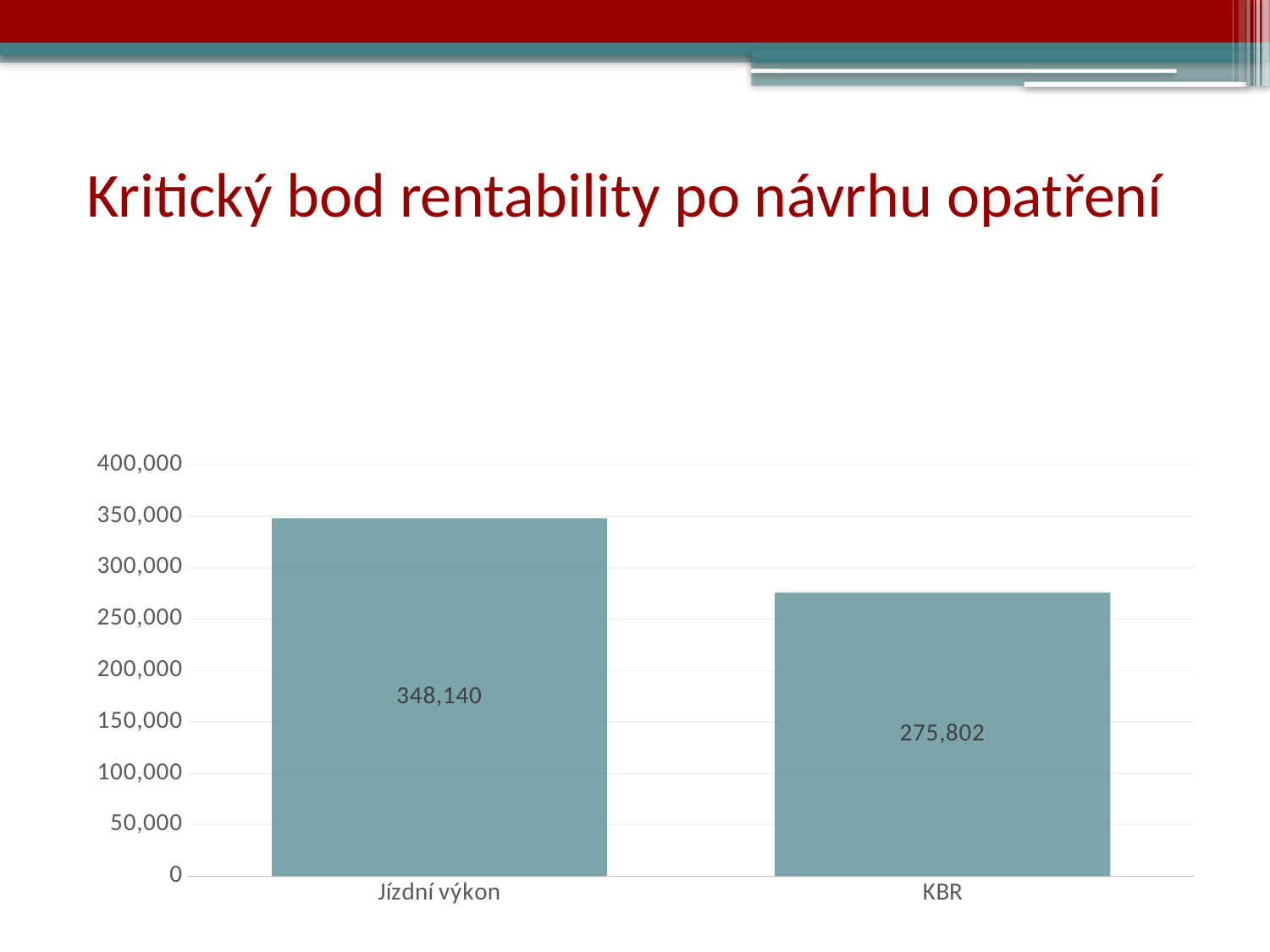
What is the value for Jízdní výkon? 348,140 How many categories are shown on the x axis? 2 What is the difference between the values for Jízdní výkon and KBR? 72,338 Is the value for KBR greater or less than 300,000? less Which category has the highest value? Jízdní výkon Is the value for Jízdní výkon greater or less than 300,000? greater What is the value for KBR? 275,802 Which is larger, the value for Jízdní výkon or the value for KBR? Jízdní výkon What kind of chart is shown on the slide? bar chart What is the title of the slide? Kritický bod rentability po návrhu opatření Do the values rise or fall from Jízdní výkon to KBR? fall Which category has the lowest value? KBR